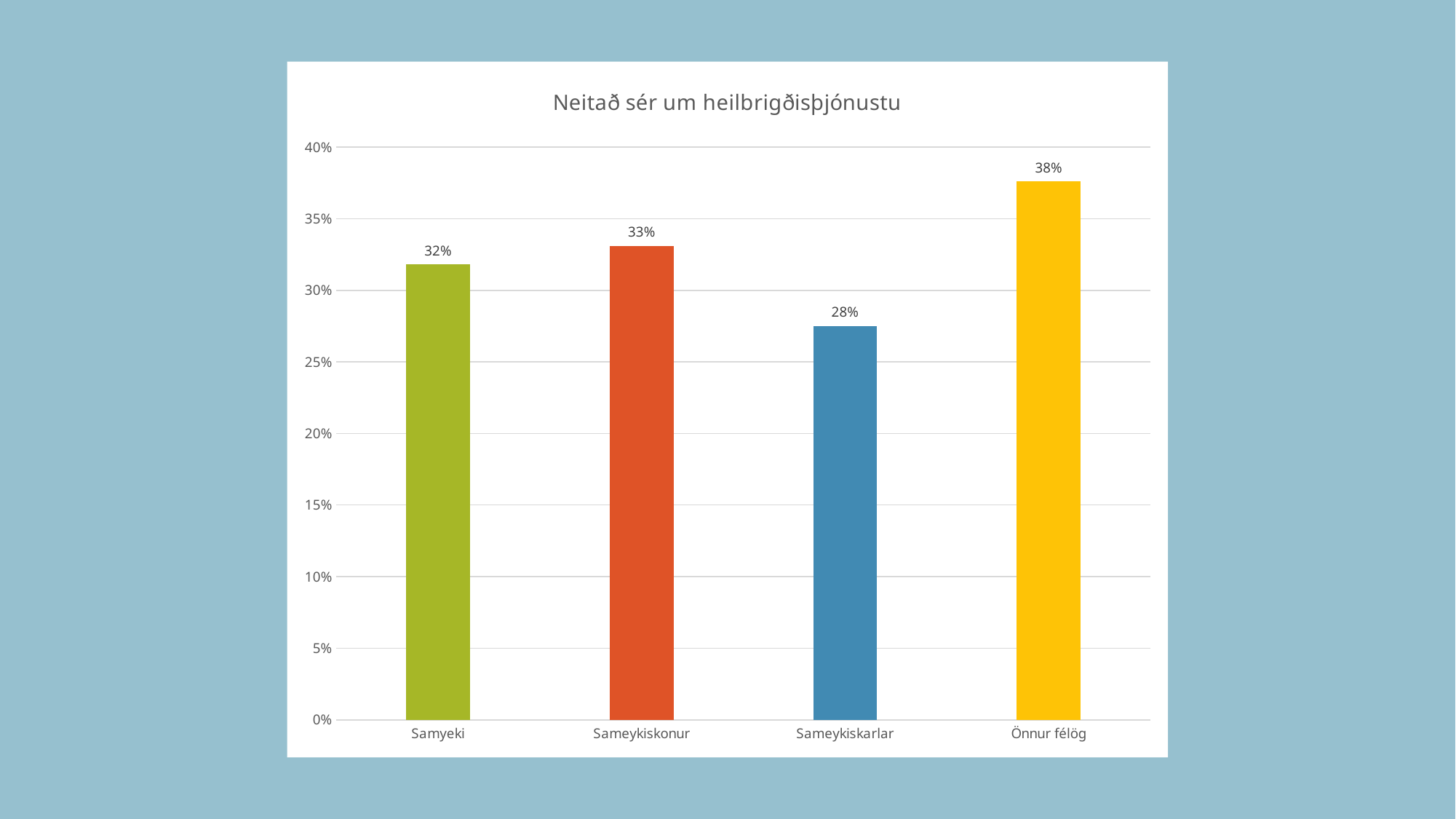
Which category has the lowest value? Sameykiskarlar What is the value for Önnur félög? 38% What is the value for Sameykiskonur? 33% What is the value for Sameykiskarlar? 28% What is the difference between the values for Önnur félög and Sameykiskarlar? 10% Which category has the highest value? Önnur félög What is the value for Samyeki? 32% How many categories are shown on the x axis? 4 What kind of chart is shown on the slide? bar chart Is the value for Sameykiskarlar greater or less than 30%? less Which is larger, the value for Samyeki or the value for Sameykiskarlar? Samyeki What is the title of the chart? Neitað sér um heilbrigðisþjónustu